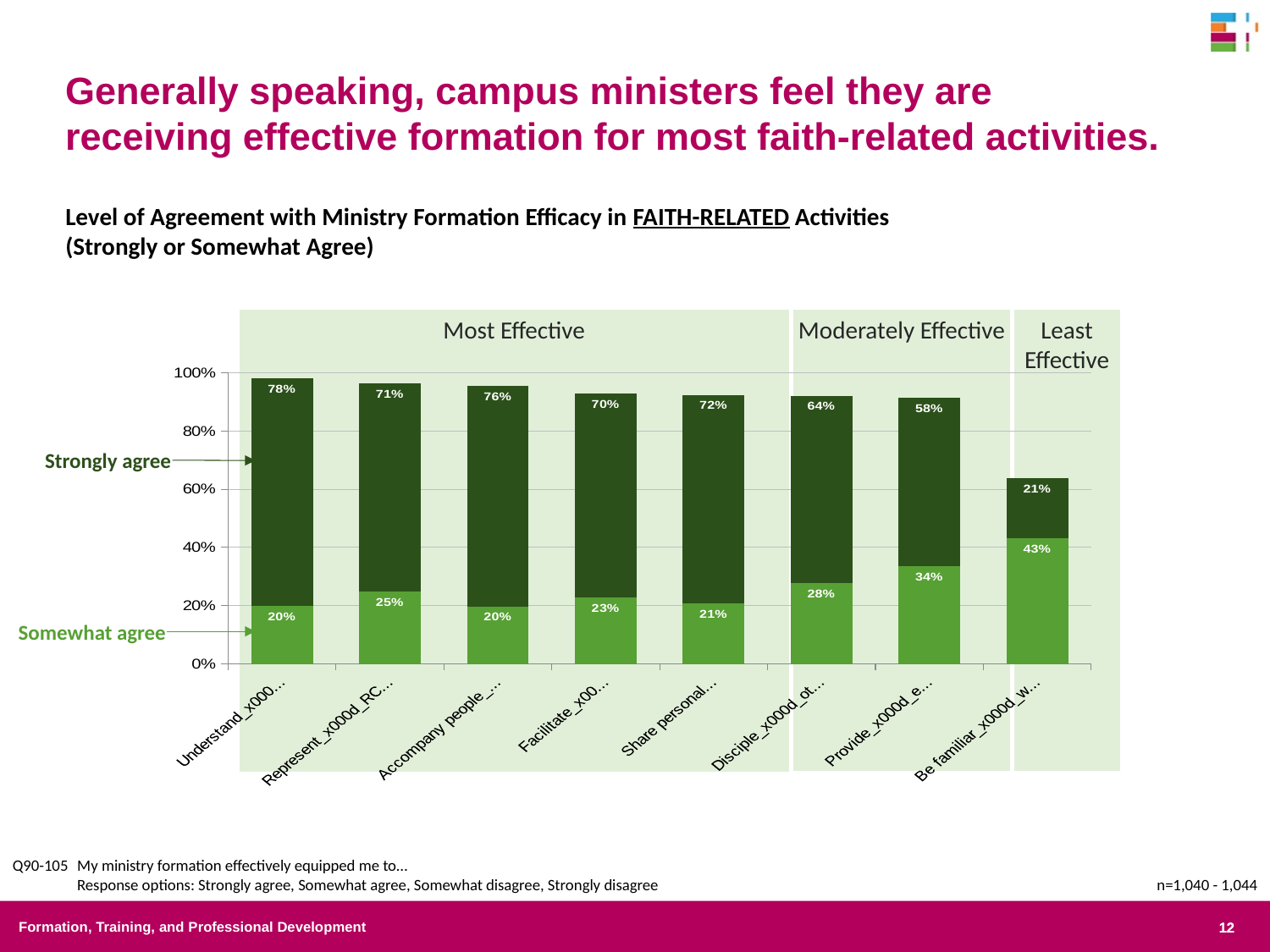
What is the combined Strongly agree plus Somewhat agree total for the first (leftmost) bar? 98% What is the difference in Strongly agree between the first (leftmost) bar and the last bar in the Least Effective group? 57 percentage points What is the Strongly agree value for the first (leftmost) bar in the Most Effective group? 78% What is the combined Strongly agree plus Somewhat agree total for the bar in the Least Effective group? 64% What kind of chart is shown on the slide? Stacked bar chart Which bar has the lowest Strongly agree value? The last bar, in the Least Effective group, 21% How many series are labelled in the chart (Strongly agree, Somewhat agree)? 2 What is the Somewhat agree value for the bar in the Least Effective group? 43% Which bar has the highest Somewhat agree value? The last bar, in the Least Effective group, 43% How many bars (activities) are plotted in the chart? 8 Within the Moderately Effective group, which bar has the higher Strongly agree value, the left one or the right one? The left one (64%) Which bar has the highest Strongly agree value? The first (leftmost) bar, 78%